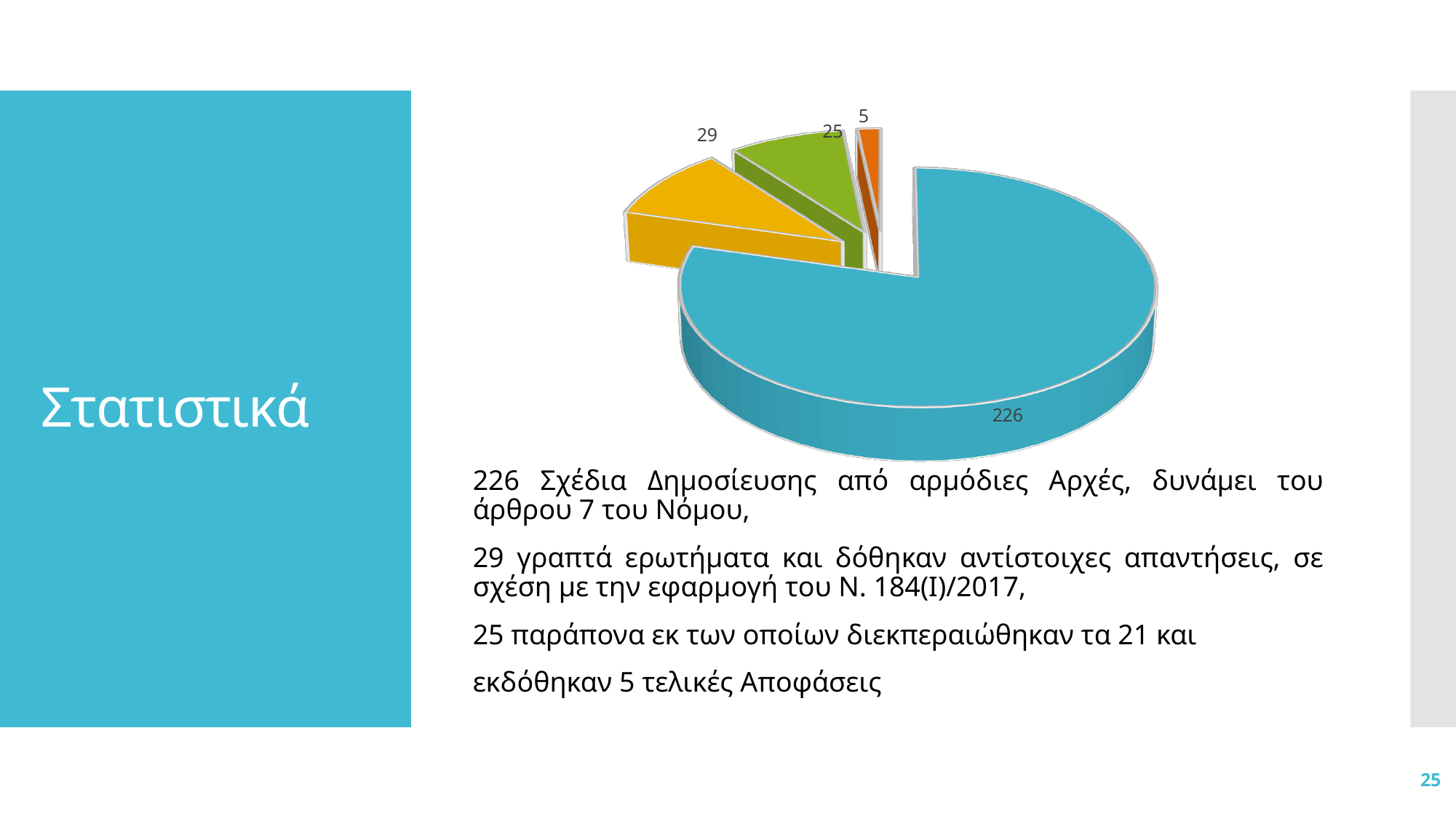
What is the value of the largest slice in the pie chart? 226 What value is labelled on the orange slice of the pie chart? 5 Which slice is larger, the yellow one or the green one? The yellow one (29) What is the difference between the yellow slice (29) and the green slice (25)? 4 What value is labelled on the yellow slice of the pie chart? 29 What value is labelled on the blue slice of the pie chart? 226 How many slices does the pie chart have? 4 What is the value of the smallest slice in the pie chart? 5 What value is labelled on the green slice of the pie chart? 25 What is the difference between the blue slice (226) and the yellow slice (29)? 197 What kind of chart is shown on the slide? Pie chart What is the total of all the values shown on the pie chart? 285